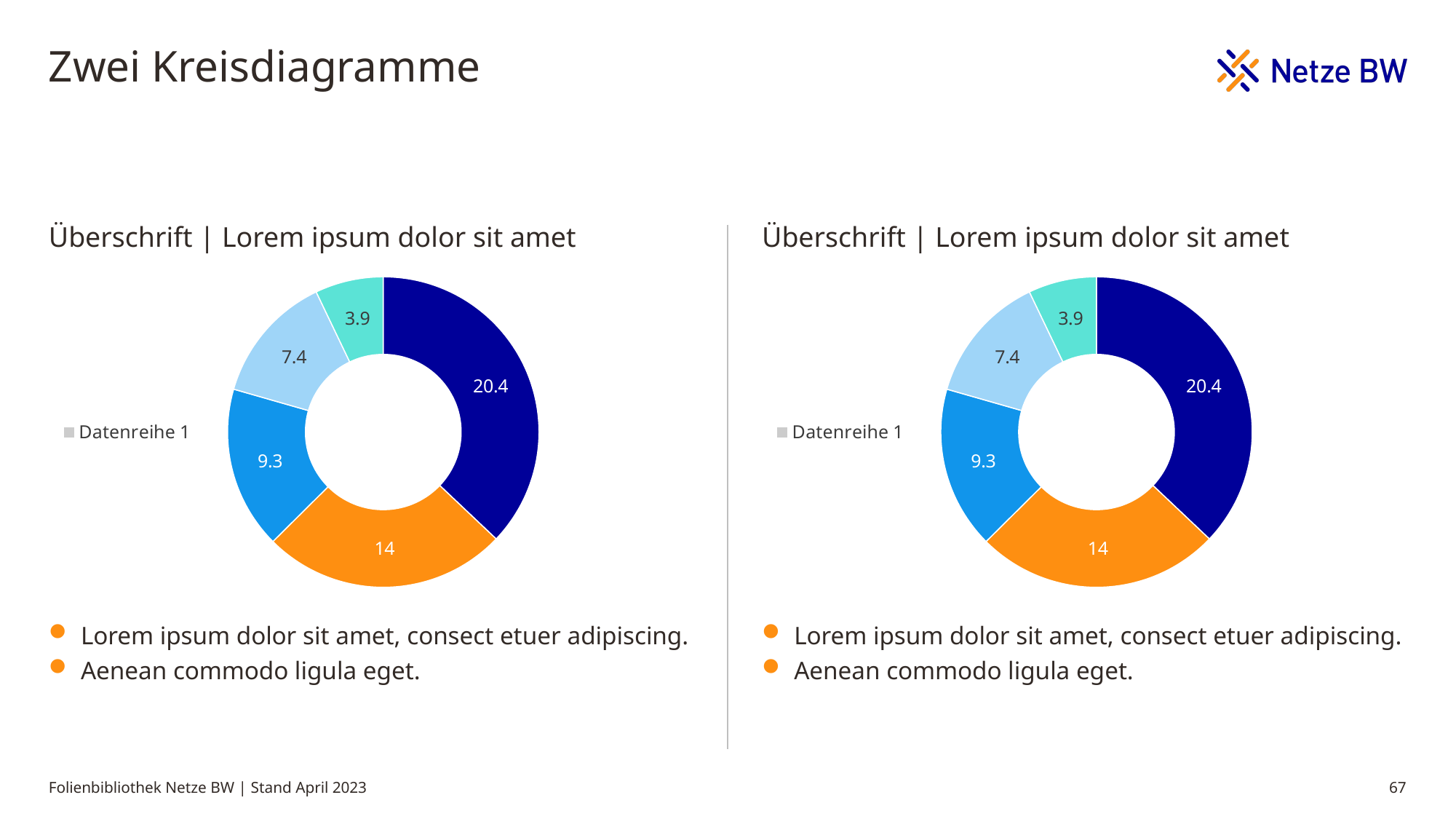
In the right chart, what is the value of the smallest slice? 3.9 In the right chart, how many series does the legend list? 1 In the right chart, which is larger: the dark blue slice or the medium blue slice? The dark blue slice (20.4) In the left chart, how many slices does the doughnut have? 5 In the left chart, what is the total of all slice values? 55 What is the name of the series shown in the legend of the left chart? Datenreihe 1 In the left chart, what is the value of the largest slice? 20.4 What kind of chart is the left chart on the slide? Doughnut (pie) chart In the right chart, what is the value shown on the light blue slice? 7.4 What is the title of the right chart? Überschrift | Lorem ipsum dolor sit amet In the left chart, what is the difference between the largest slice (20.4) and the orange slice (14)? 6.4 In the left chart, what is the value shown on the orange slice? 14